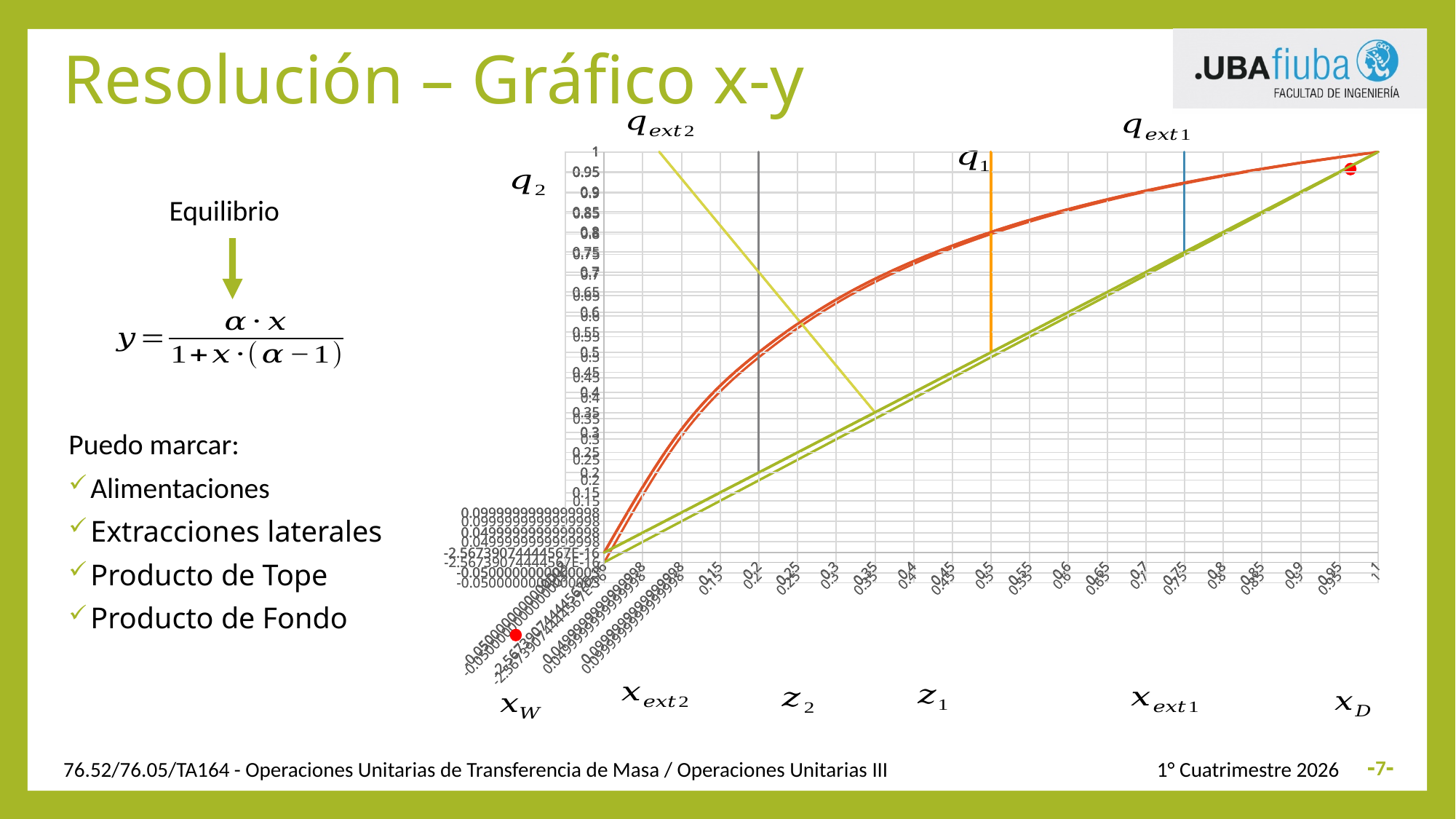
Is the value of the red equilibrium curve at x = 0.2 greater or less than 0.4? greater Is the vertical orange line labelled q1 located at an x value greater or less than 0.4? greater Does the red equilibrium curve rise or fall as x increases along the x axis? rise At x = 0.5, which is higher: the red equilibrium curve or the green diagonal line? the red equilibrium curve Is the value of the red equilibrium curve at x = 0.75 greater or less than 0.8? greater What is the highest value shown on the y axis of the chart? 1 What is the title of the slide containing the chart? Resolución – Gráfico x-y What kind of chart is shown on the slide? line chart